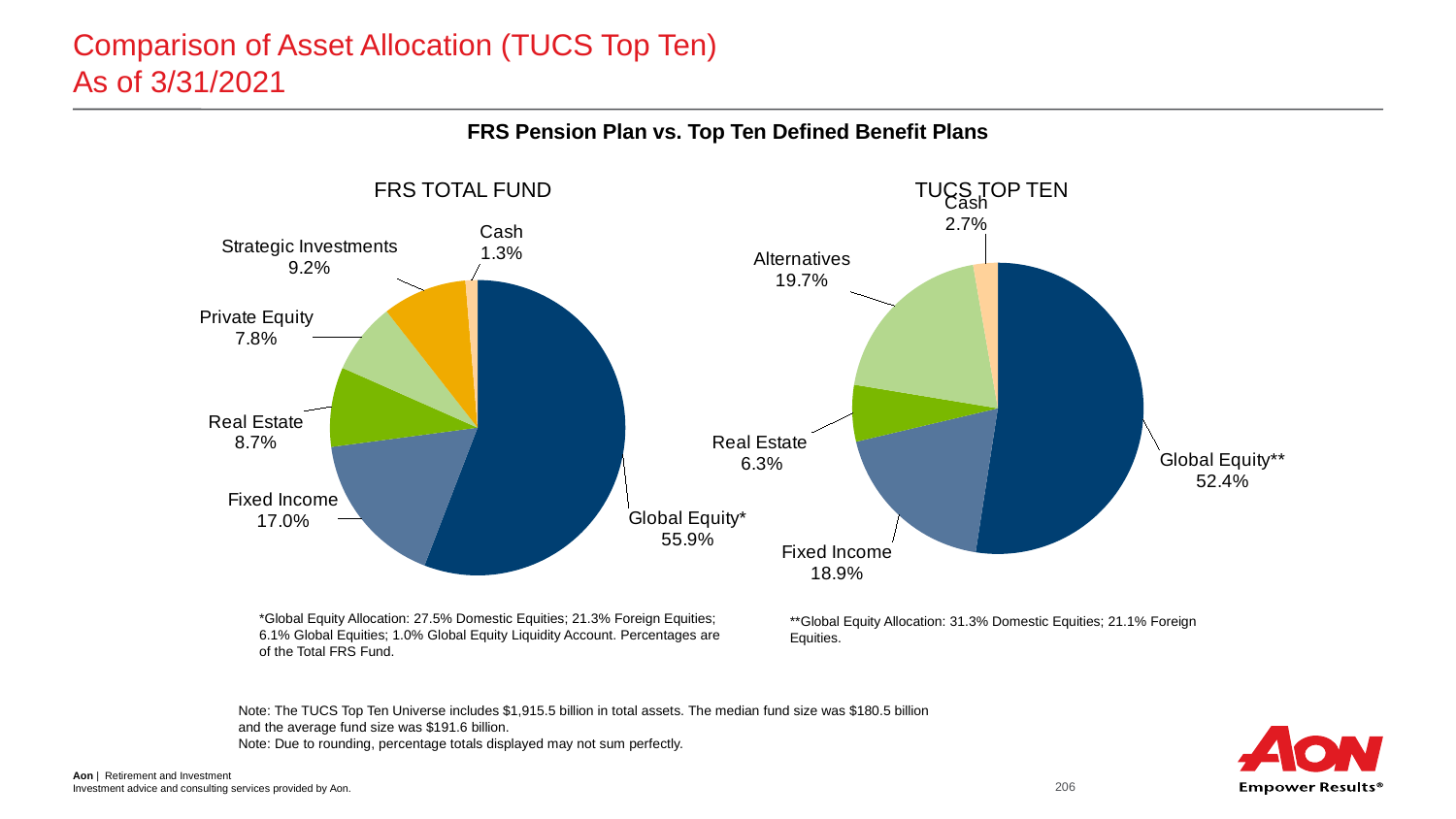
What type of chart is used for the TUCS TOP TEN data? Pie chart In the FRS TOTAL FUND chart, what share does Global Equity* have? 55.9% In the TUCS TOP TEN chart, which category has the largest share? Global Equity** In the TUCS TOP TEN chart, what share does Alternatives have? 19.7% In the FRS TOTAL FUND chart, what is the value for Strategic Investments? 9.2% How many slices does the TUCS TOP TEN pie chart have? 5 Which is larger: Real Estate in the FRS TOTAL FUND chart or Real Estate in the TUCS TOP TEN chart? FRS TOTAL FUND In the FRS TOTAL FUND chart, which category has the smallest share? Cash In the TUCS TOP TEN chart, what is the difference between Global Equity** and Fixed Income? 33.5% How many slices does the FRS TOTAL FUND pie chart have? 6 In the TUCS TOP TEN chart, what is the value for Cash? 2.7% In the FRS TOTAL FUND chart, what is the difference between Fixed Income and Real Estate? 8.3%